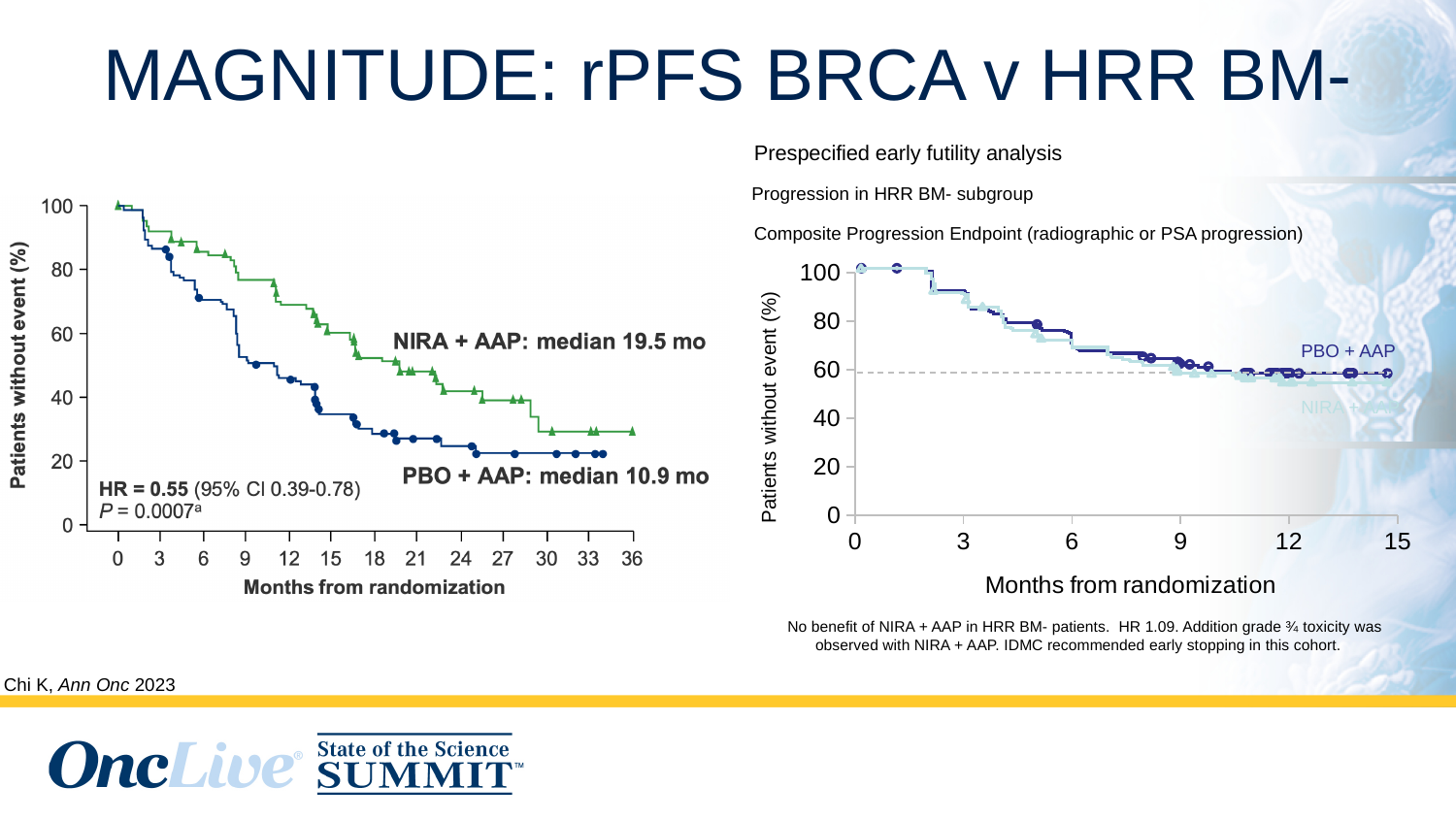
In the left chart (BRCA rPFS), what hazard ratio is shown? HR = 0.55 In the left chart (BRCA rPFS), what is the median for NIRA + AAP? 19.5 mo In the left chart (BRCA rPFS), which arm has the longer median, NIRA + AAP or PBO + AAP? NIRA + AAP In the left chart (BRCA rPFS), is the value for NIRA + AAP at 12 months greater or less than 60? greater In the left chart (BRCA rPFS), what is the median for PBO + AAP? 10.9 mo In the right chart (HRR BM- subgroup), do the curves rise or fall as months from randomization increase? Fall In the left chart (BRCA rPFS), what is the difference in months between the NIRA + AAP median and the PBO + AAP median? 8.6 mo How many treatment arms are plotted in the right chart (HRR BM- subgroup)? 2 In the right chart (HRR BM- subgroup), is the value for PBO + AAP at 6 months greater or less than 60? greater What kind of chart is the left chart (BRCA rPFS)? Line chart (Kaplan-Meier curve) In the left chart (BRCA rPFS), what is the 95% CI shown for the hazard ratio? 0.39-0.78 In the left chart (BRCA rPFS), is the value for PBO + AAP at 12 months greater or less than 60? less